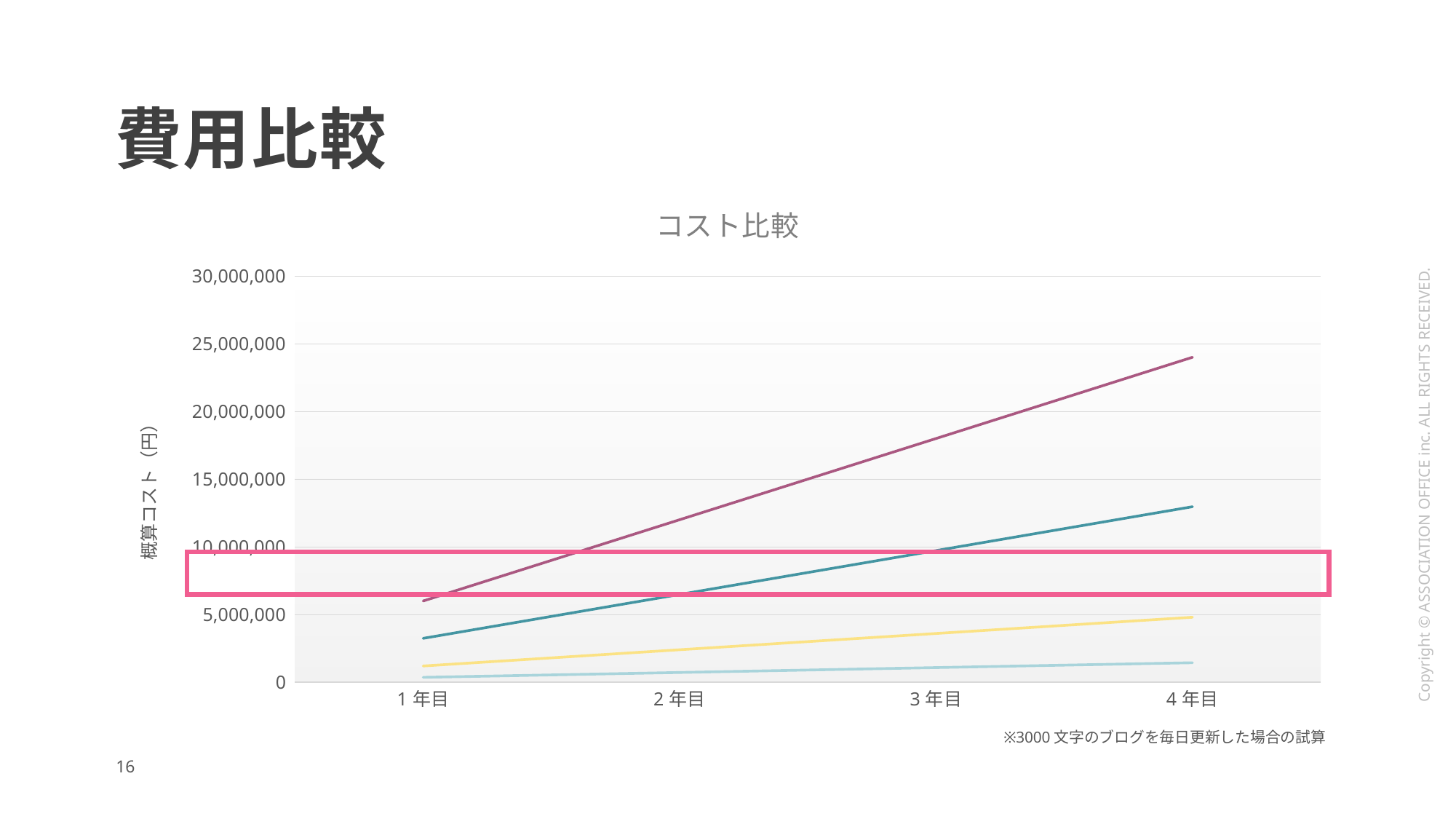
Which line has the lowest value at 4年目? the light blue line What kind of chart is shown on the slide? line chart At 4年目, which is larger: the value of the teal line or the value of the yellow line? the teal line What is the label of the vertical axis? 概算コスト（円） Is the value of the purple line at 1年目 greater or less than 5,000,000? greater Is the value of the purple line at 4年目 greater or less than 20,000,000? greater Which line has the highest value at 4年目? the purple line Do the values of the purple line rise or fall from 1年目 to 4年目? rise How many categories are shown on the x axis of the chart? 4 How many lines are plotted in the chart? 4 What is the title of the chart? コスト比較 Is the value of the teal line at 4年目 greater or less than 15,000,000? less